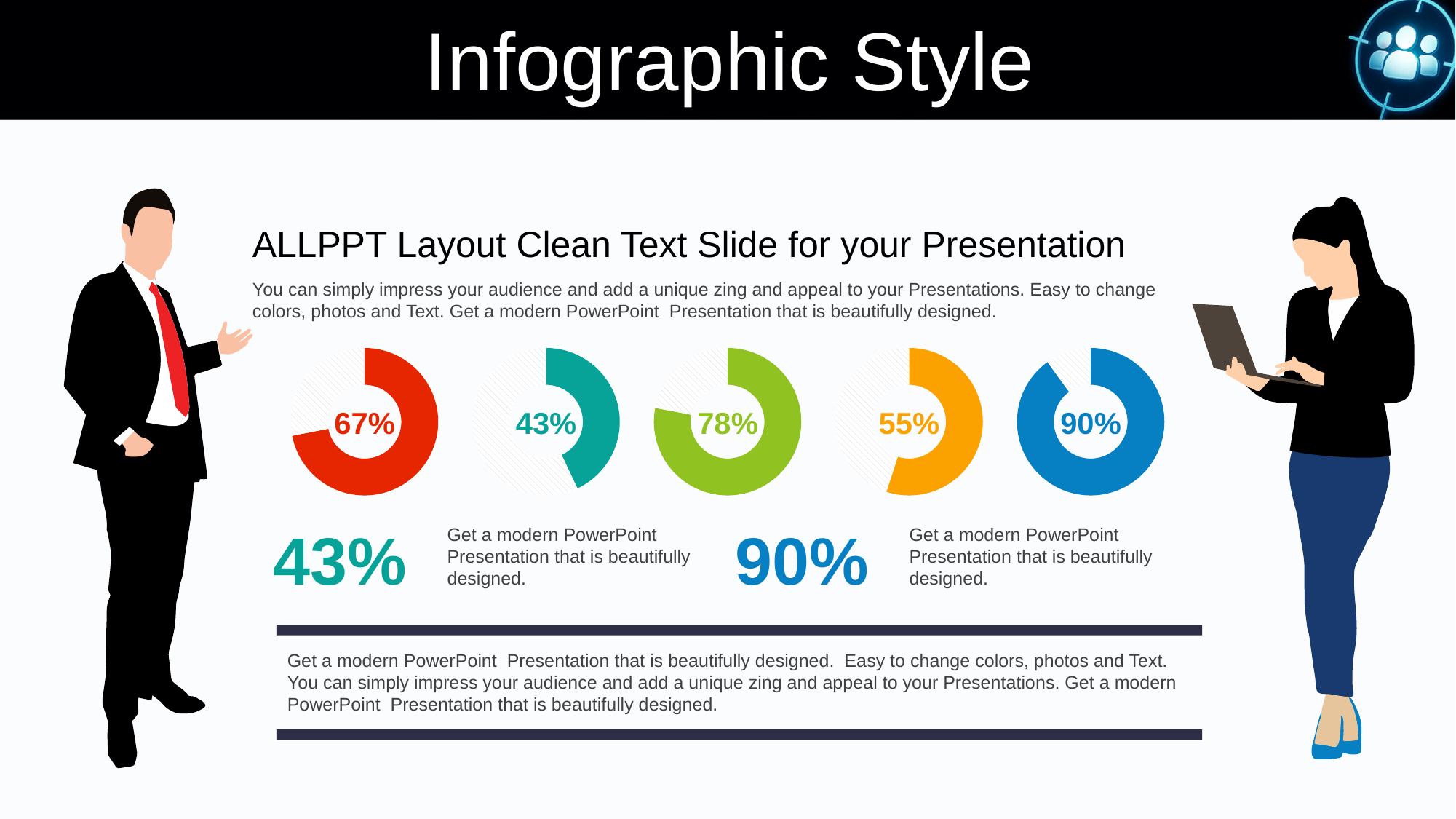
How many donut charts are shown on the slide? 5 What value is shown in the red donut chart, the first from the left? 67% Which is larger, the value in the orange donut chart or the value in the red donut chart? The red donut chart (67%) What value is shown in the teal donut chart, the second from the left? 43% Which donut chart shows the highest percentage? The blue one (90%) What kind of charts are used to display the percentages on the slide? Donut (pie) charts What is the difference between the value in the blue donut chart and the value in the teal donut chart? 47% Which donut chart shows the lowest percentage? The teal one (43%) What is the difference between the value in the green donut chart and the value in the red donut chart? 11% What value is shown in the green donut chart in the middle? 78% What value is shown in the orange donut chart, the fourth from the left? 55% What value is shown in the blue donut chart, the rightmost one? 90%